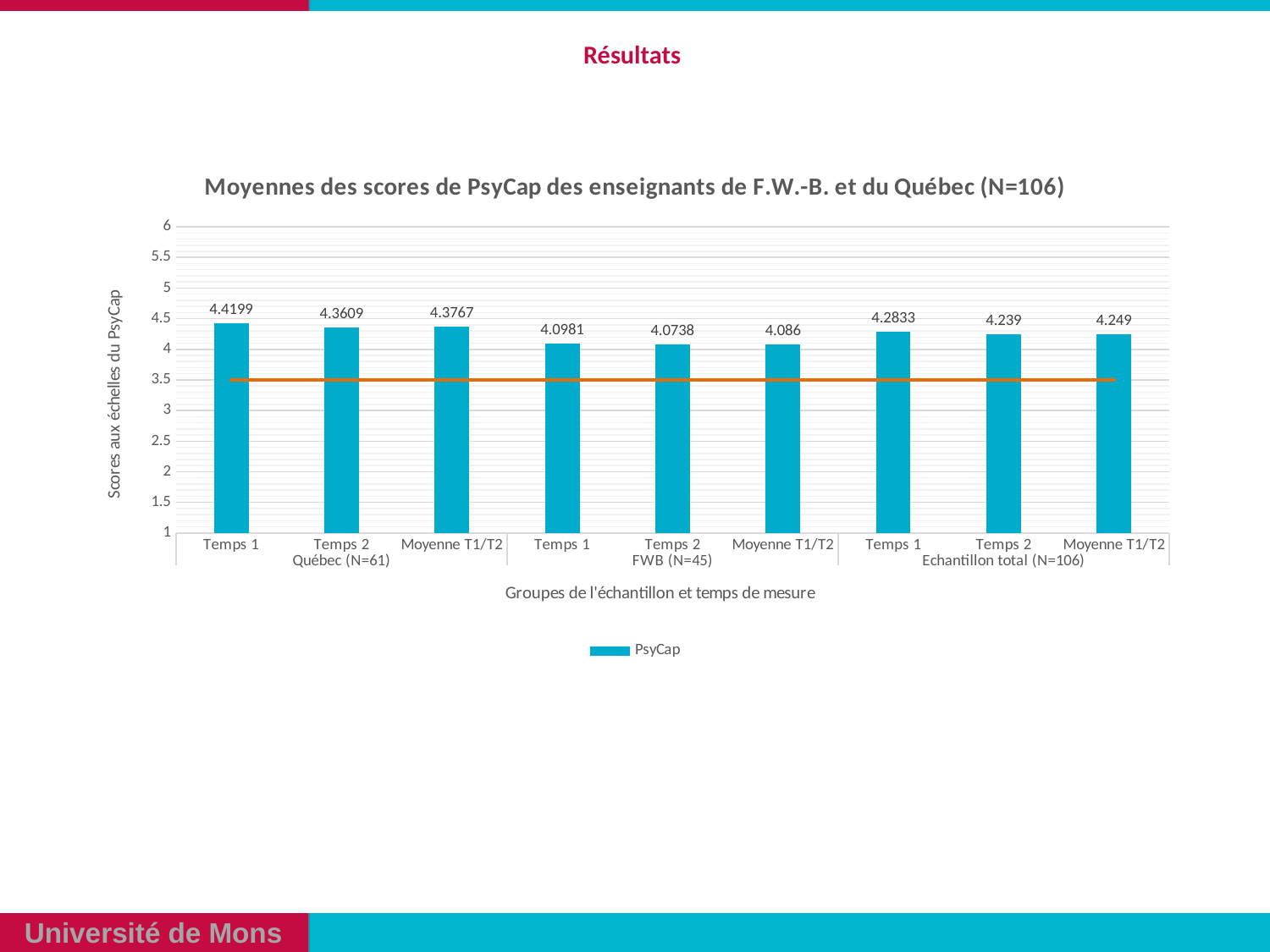
How many bars are plotted in the chart? 9 Which bar has the lowest PsyCap score? Temps 2, FWB (N=45) What is the PsyCap score for Temps 2 in the FWB (N=45) group? 4.0738 Is the Temps 2 score for the Echantillon total (N=106) group greater or less than 4? greater How many series does the legend list? 1 What is the difference between the Temps 1 score for Québec (N=61) and the Temps 1 score for FWB (N=45)? 0.3218 Which bar has the highest PsyCap score? Temps 1, Québec (N=61) What is the PsyCap score for Temps 1 in the Québec (N=61) group? 4.4199 What is the title of the chart? Moyennes des scores de PsyCap des enseignants de F.W.-B. et du Québec (N=106) What is the Moyenne T1/T2 PsyCap score for the Echantillon total (N=106) group? 4.249 What kind of chart is shown on the slide? Combination bar and line chart Which is larger: the Moyenne T1/T2 score for Québec (N=61) or the Moyenne T1/T2 score for FWB (N=45)? Moyenne T1/T2 for Québec (N=61)